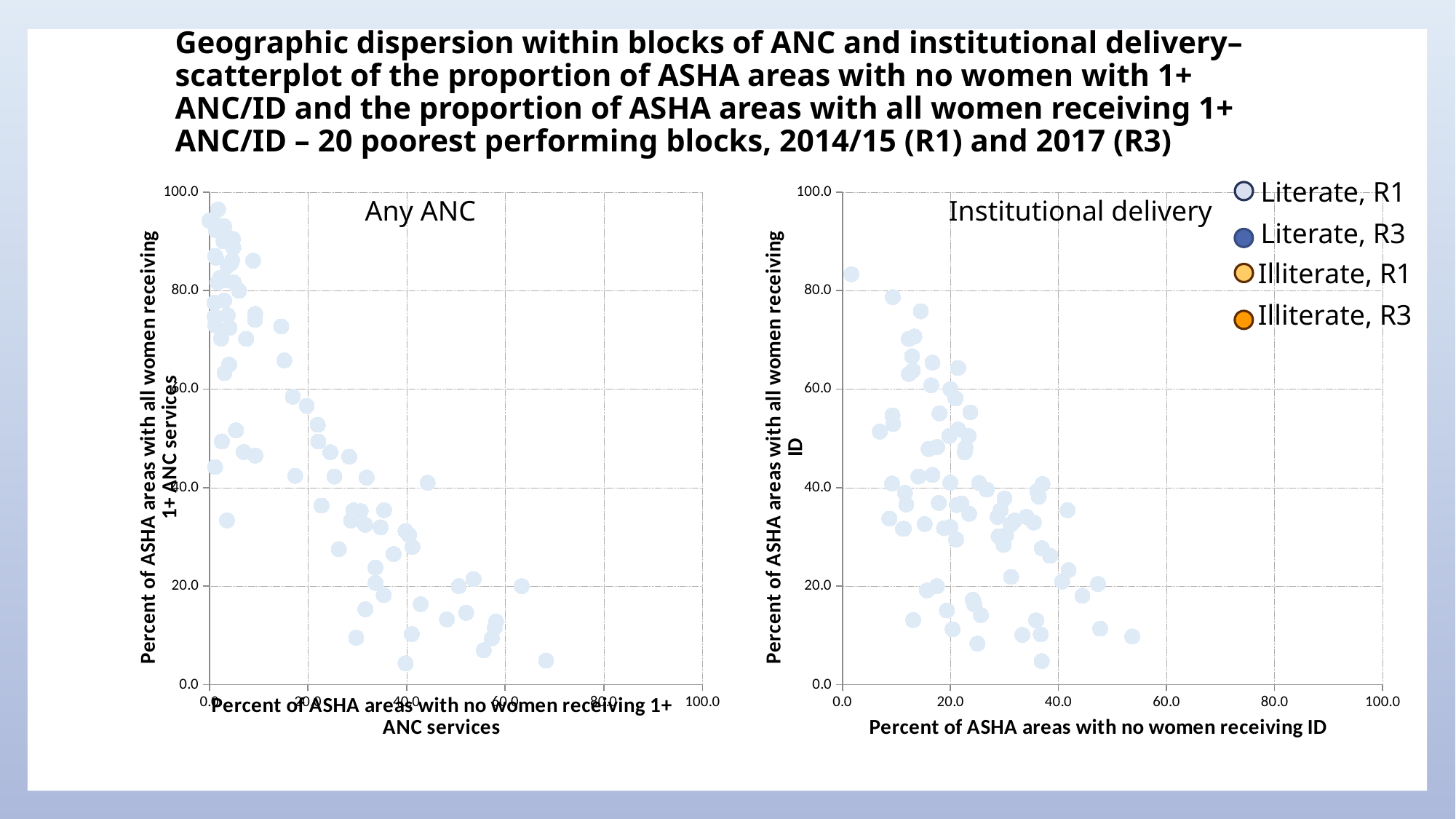
In the 'Any ANC' chart, do the y values generally rise or fall as the x value increases? Fall What kind of chart is the 'Any ANC' chart on the left? Scatter plot In the 'Any ANC' chart, is the highest x value among the plotted points greater or less than 80.0? less In the 'Institutional delivery' chart, do the y values generally rise or fall as the x value increases? Fall In the 'Any ANC' chart, is the highest y value among the plotted points greater or less than 80.0? greater What is the maximum value shown on the y axis of the 'Any ANC' chart? 100.0 In the 'Institutional delivery' chart, is the highest y value among the plotted points greater or less than 80.0? greater What kind of chart is the 'Institutional delivery' chart on the right? Scatter plot What is the label of the x axis on the 'Any ANC' chart? Percent of ASHA areas with no women receiving 1+ ANC services What is the label of the x axis on the 'Institutional delivery' chart? Percent of ASHA areas with no women receiving ID How many series does the legend list? 4